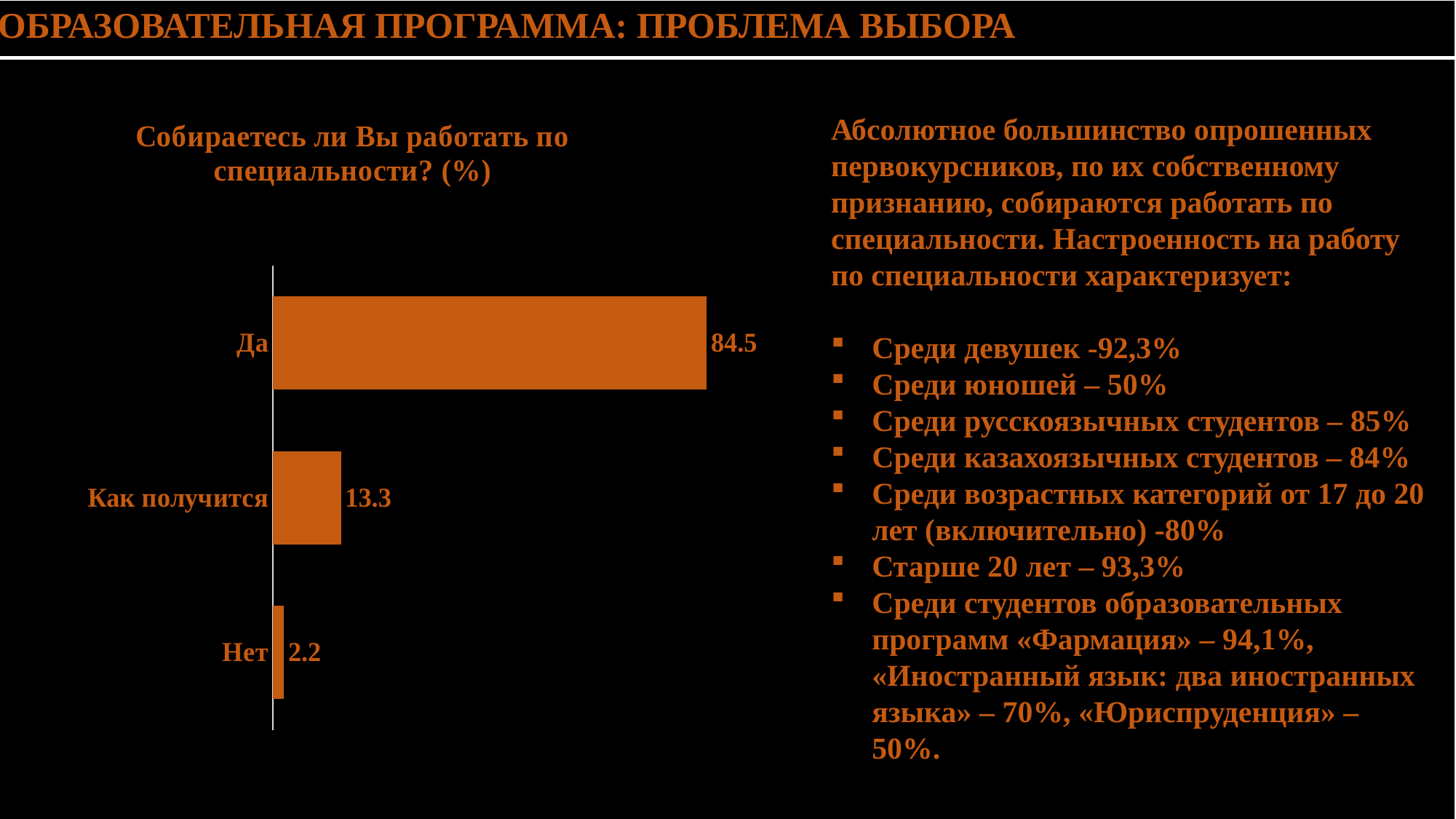
What is the title of the chart? Собираетесь ли Вы работать по специальности? (%) What is the value for "Нет" in the chart? 2.2 Which category has the highest value in the chart? Да What is the value for "Да" in the chart? 84.5 How many categories are shown in the chart? 3 What is the difference between the values for "Да" and "Как получится"? 71.2 What is the difference between the values for "Как получится" and "Нет"? 11.1 What colour are the bars in the chart? orange Which category has the lowest value in the chart? Нет What is the value for "Как получится" in the chart? 13.3 What kind of chart is shown on the slide? bar chart Which is larger, the value for "Как получится" or the value for "Нет"? Как получится